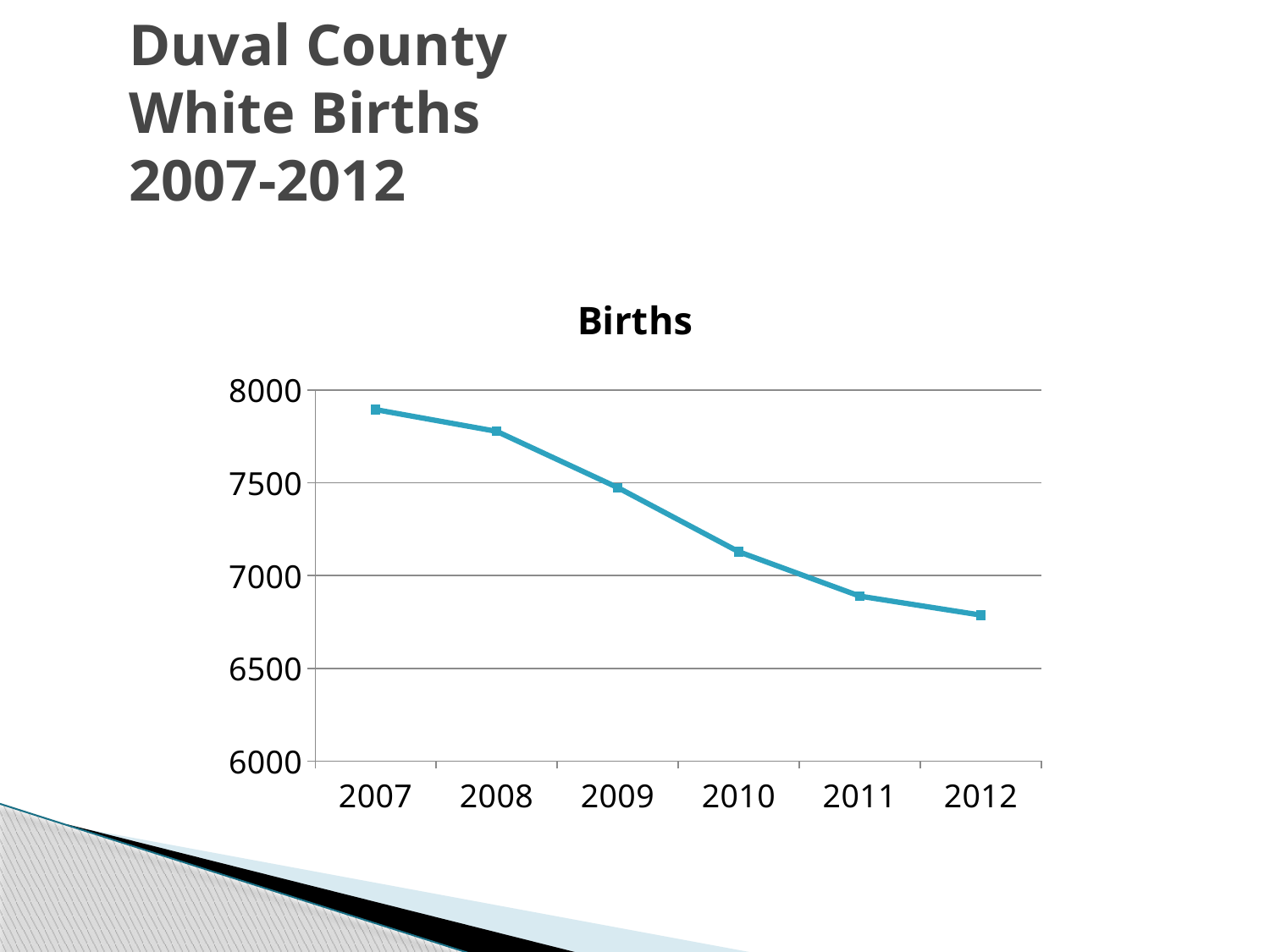
Is the value for 2010 greater or less than 7500? less What kind of chart is shown on the slide? line chart Is the value for 2011 greater or less than 7000? less Which year has the highest number of births? 2007 What is the title of the chart? Births Which year has the lowest number of births? 2012 Is the value for 2007 greater or less than 7500? greater How many years are plotted on the x axis? 6 Which year has more births, 2008 or 2010? 2008 What is the lowest value shown on the y axis? 6000 Do the values rise or fall from 2007 to 2012? fall